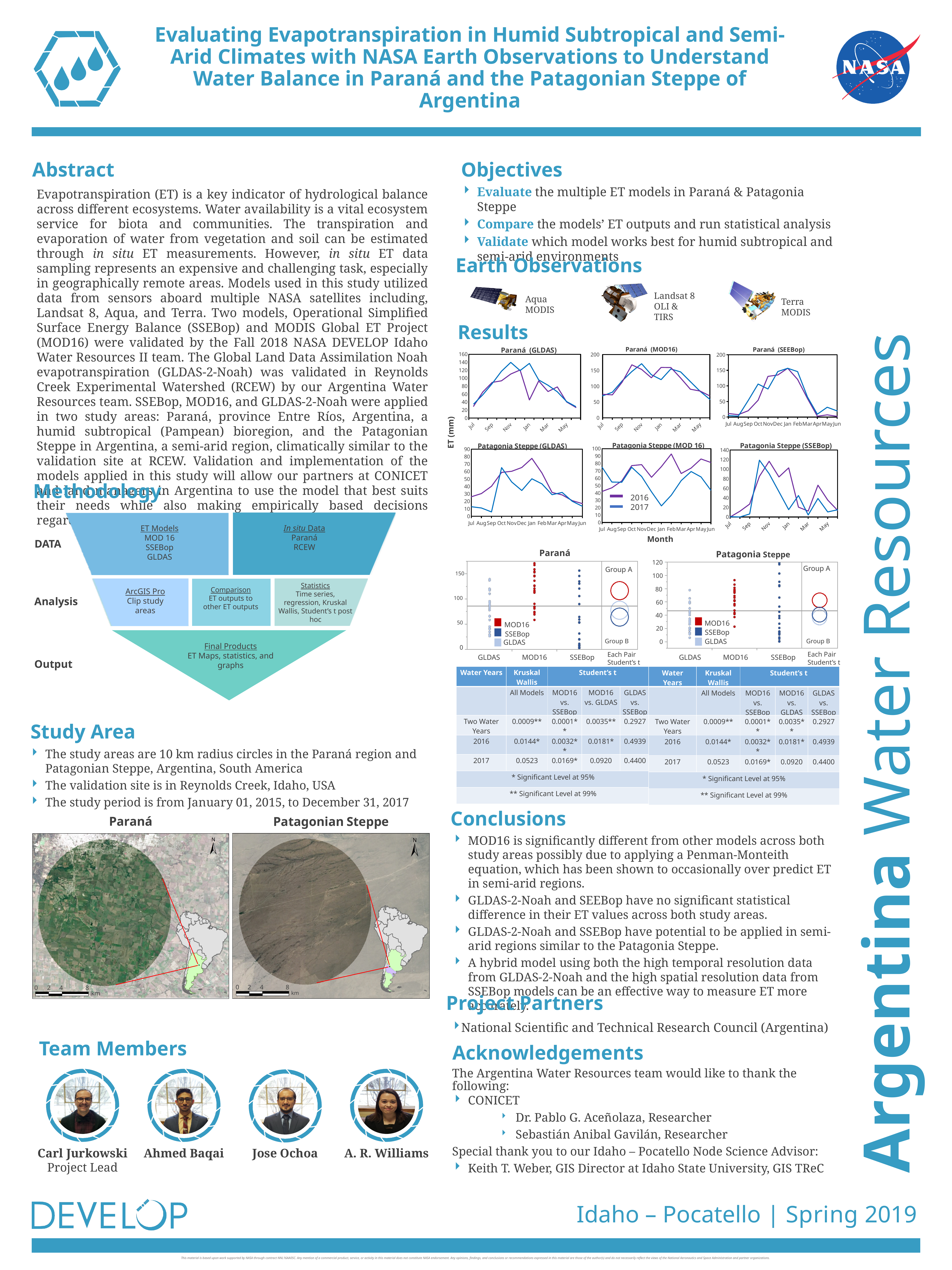
How many series does the legend list in the Paraná dot plot below the line charts? 3 What is the y-axis label of the monthly ET line charts in the Results section? ET (mm) In the Paraná (MOD16) chart, is the peak value greater or less than 100? greater In the Paraná (SEEBop) chart, is the value for Jul greater or less than 50? less Which two years are listed in the legend of the monthly ET line charts? 2016 and 2017 In the Patagonia Steppe (GLDAS) chart, is the value for Jul greater or less than 50? less How many monthly ET line charts are shown in the Results section? 6 What kind of chart is the Paraná (GLDAS) chart in the Results section? line chart How many series does the legend list for the monthly ET line charts in the Results section? 2 In the Patagonia Steppe (MOD 16) chart, which series has the larger value in Jan, 2016 or 2017? 2016 In the Paraná (GLDAS) chart, do the values rise or fall from Jul to Nov? rise